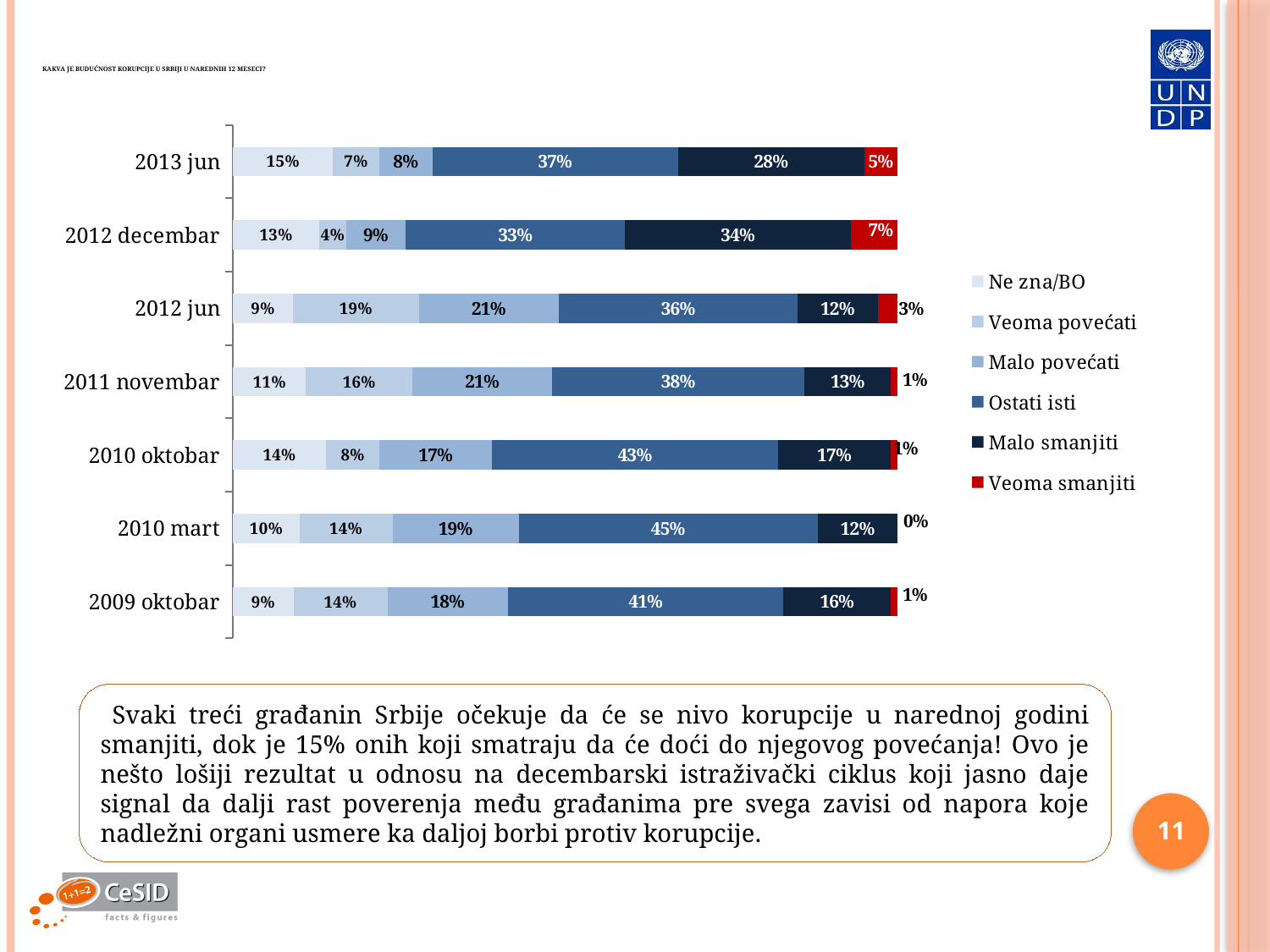
How many series does the legend list? 6 What is the total of the stacked bar for 2013 jun? 100% What kind of chart is shown on the slide? Stacked bar chart What is the value for "Ostati isti" in 2013 jun? 37% How many survey waves are shown on the chart? 7 Which is larger: the "Veoma povećati" value for 2012 jun or for 2013 jun? 2012 jun Which survey wave has the highest value for "Malo smanjiti"? 2012 decembar What is the value for "Ne zna/BO" in 2010 oktobar? 14% Which survey wave has the lowest value for "Veoma smanjiti"? 2010 mart Which survey wave has the highest value for "Ostati isti"? 2010 mart What is the value for "Veoma smanjiti" in 2012 decembar? 7% What is the difference between the "Malo smanjiti" values for 2012 decembar and 2013 jun? 6 percentage points